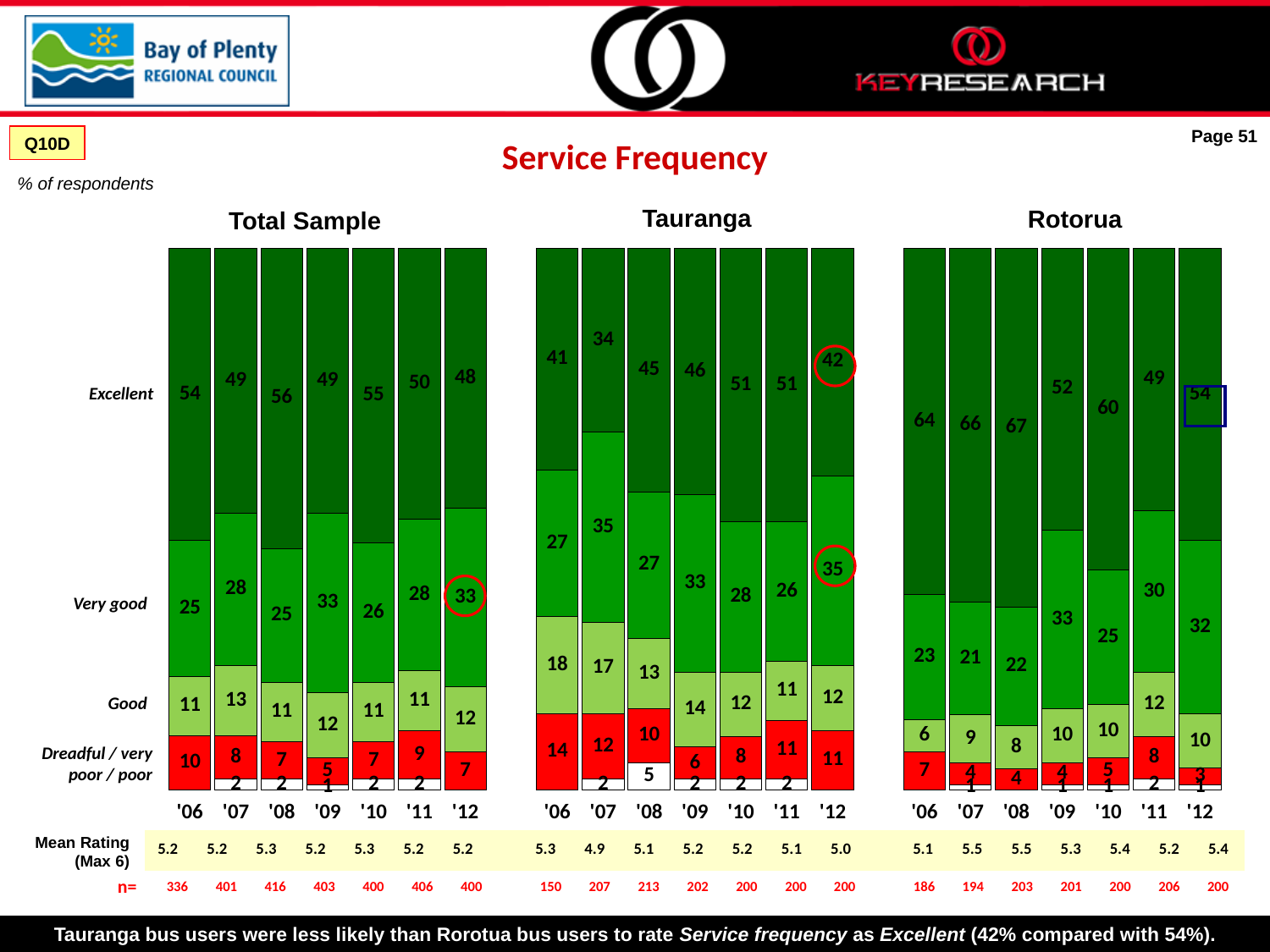
In the Tauranga chart, is the Excellent value larger in '06 or '07? '06 What kind of chart is used for the Tauranga data? Stacked bar chart In the Tauranga chart, what is the Excellent value for '12? 42 In the Tauranga chart, what is the Dreadful / very poor / poor value for '06? 14 In the Total Sample chart, what is the Very good value for '09? 33 In the Total Sample chart, what percentage of respondents rated service frequency as Excellent in '08? 56 In the Rotorua chart, what is the Excellent value for '12? 54 How many years are shown on the x axis of the Total Sample chart? 7 In the Tauranga chart, which year has the lowest Excellent value? '07 What is the difference between the Rotorua Excellent value for '12 and the Tauranga Excellent value for '12? 12 In the Rotorua chart, which year has the highest Excellent value? '08 In the Rotorua chart, does the Excellent value rise or fall from '06 to '08? Rise